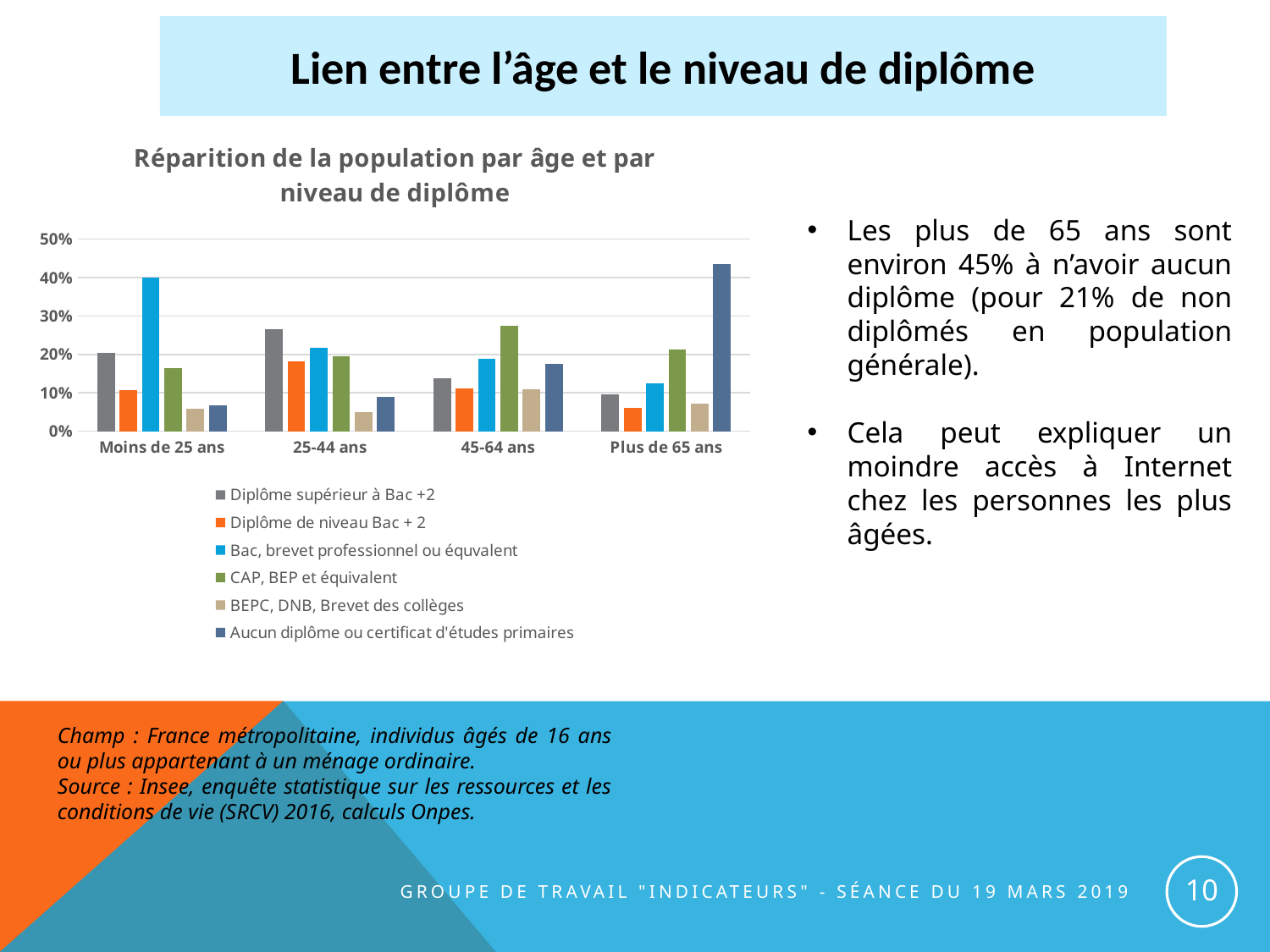
What is the title of the chart? Réparition de la population par âge et par niveau de diplôme Is the value for 'CAP, BEP et équivalent' in the '45-64 ans' group greater or less than 20%? greater How many age groups are shown on the x axis of the chart? 4 Which age group has the highest value for 'Aucun diplôme ou certificat d'études primaires'? Plus de 65 ans Which age group has the lowest value for 'Bac, brevet professionnel ou équvalent'? Plus de 65 ans Is the value for 'Aucun diplôme ou certificat d'études primaires' in the 'Plus de 65 ans' group greater or less than 40%? greater Does the value for 'Aucun diplôme ou certificat d'études primaires' rise or fall as the age groups go from 'Moins de 25 ans' to 'Plus de 65 ans'? rise Is the value for 'Bac, brevet professionnel ou équvalent' in the 'Moins de 25 ans' group greater or less than 30%? greater Within the 'Moins de 25 ans' group, which diploma level has the highest bar? Bac, brevet professionnel ou équvalent Which is larger: the value for 'Diplôme supérieur à Bac +2' in the '25-44 ans' group or in the 'Plus de 65 ans' group? 25-44 ans How many series does the chart's legend list? 6 What kind of chart is shown on the slide? bar chart